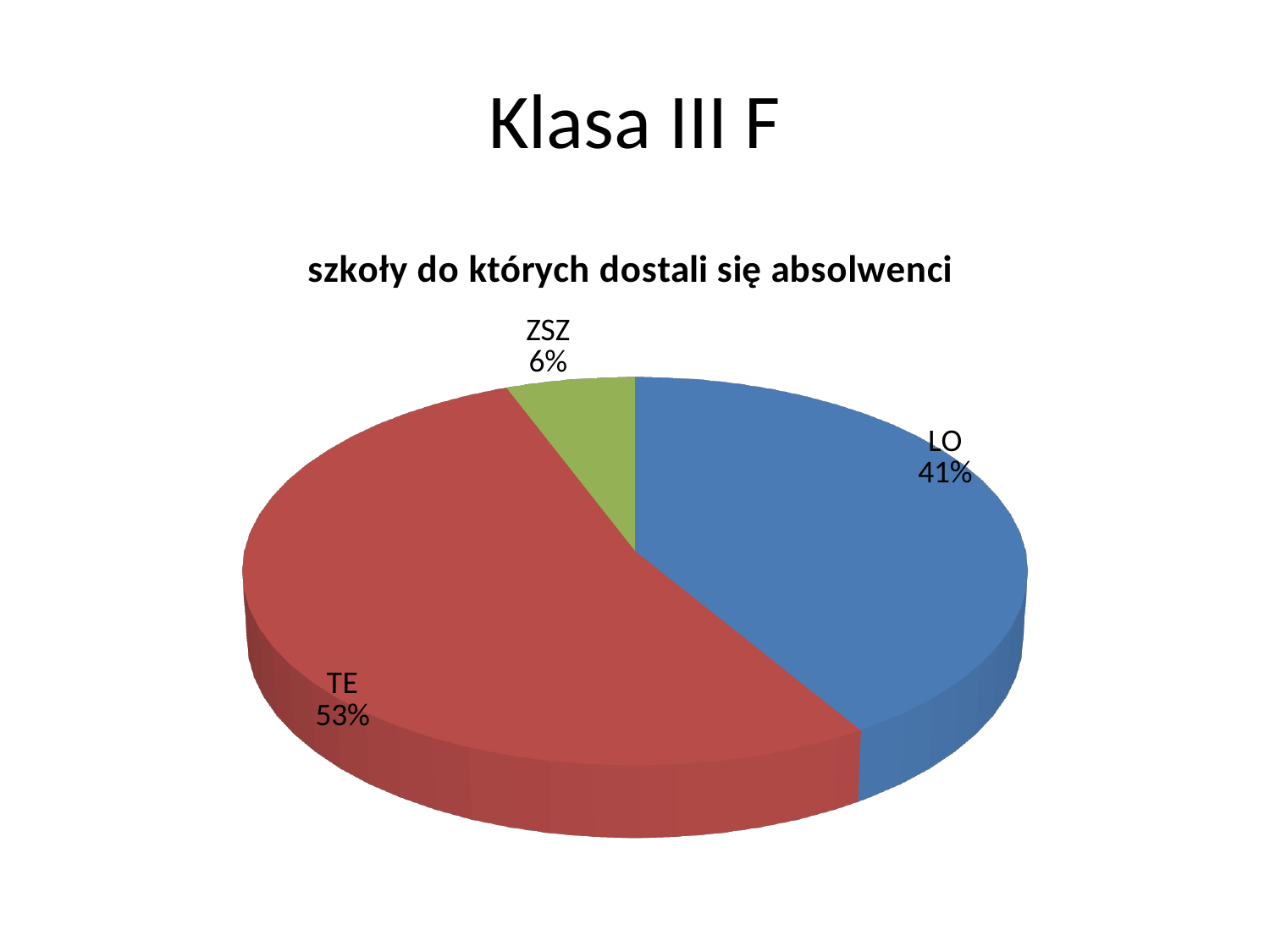
What is the difference in percentage points between the LO and ZSZ slices? 35 Which category has the smallest slice of the pie? ZSZ What kind of chart is shown on the slide? pie chart What share of the pie does TE have? 53% Which category has the largest slice of the pie? TE Which slice is larger, LO or ZSZ? LO How many categories are shown in the pie chart? 3 What share of the pie does ZSZ have? 6% What is the title of the chart? szkoły do których dostali się absolwenci What is the difference in percentage points between the TE and LO slices? 12 What share of the pie does LO have? 41% Which slice is larger, TE or LO? TE